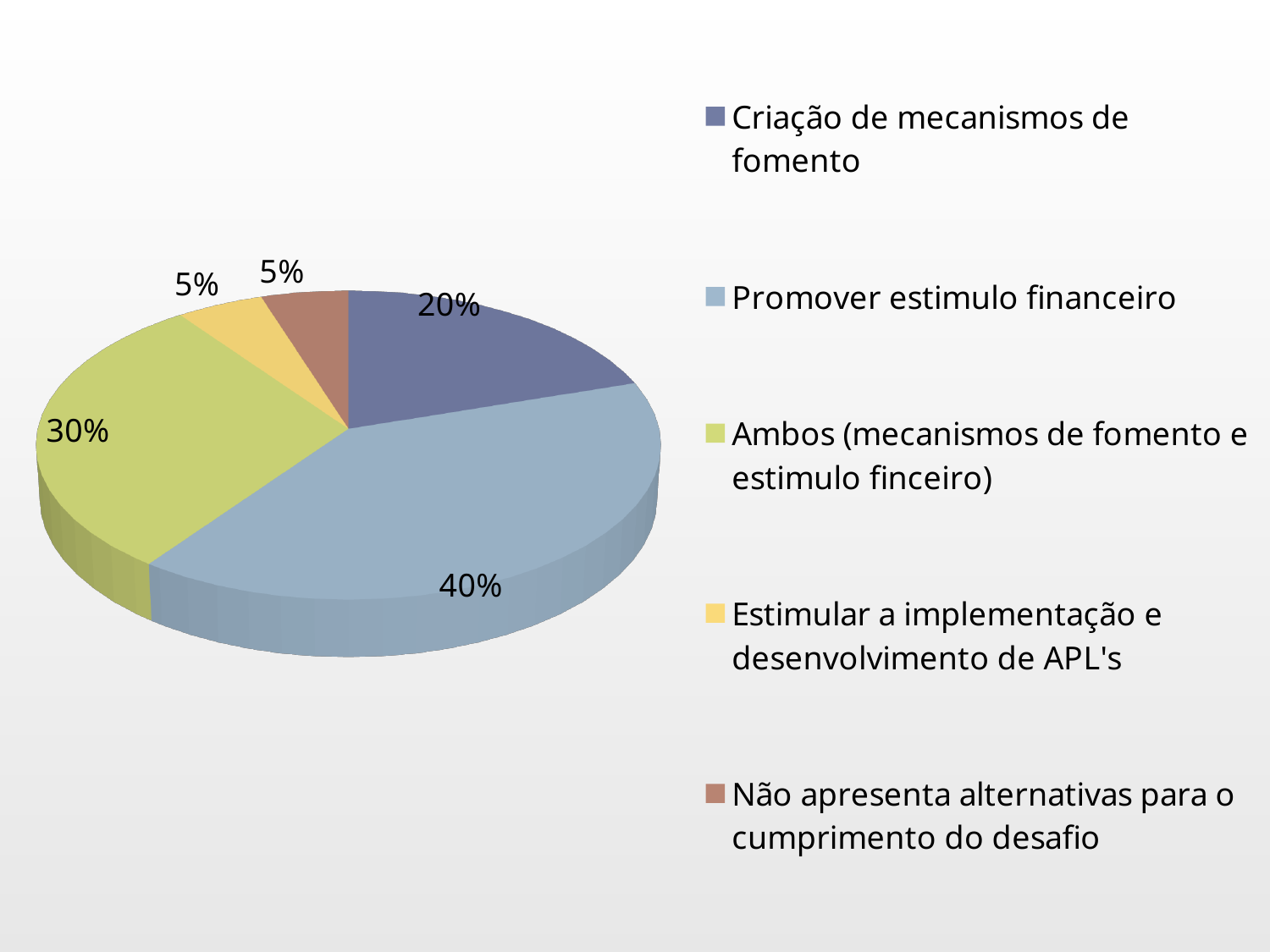
What colour is the slice for "Promover estimulo financeiro"? Light blue What share of the pie does "Promover estimulo financeiro" represent? 40% What share of the pie does "Ambos (mecanismos de fomento e estimulo finceiro)" represent? 30% What is the difference in percentage points between "Promover estimulo financeiro" and "Ambos (mecanismos de fomento e estimulo finceiro)"? 10% What share of the pie does "Estimular a implementação e desenvolvimento de APL's" represent? 5% How many entries does the legend list? 5 Which is larger: the slice for "Criação de mecanismos de fomento" or the slice for "Ambos (mecanismos de fomento e estimulo finceiro)"? Ambos (mecanismos de fomento e estimulo finceiro) How many slices does the pie chart have? 5 Which category has the largest slice of the pie? Promover estimulo financeiro What kind of chart is shown on the slide? Pie chart